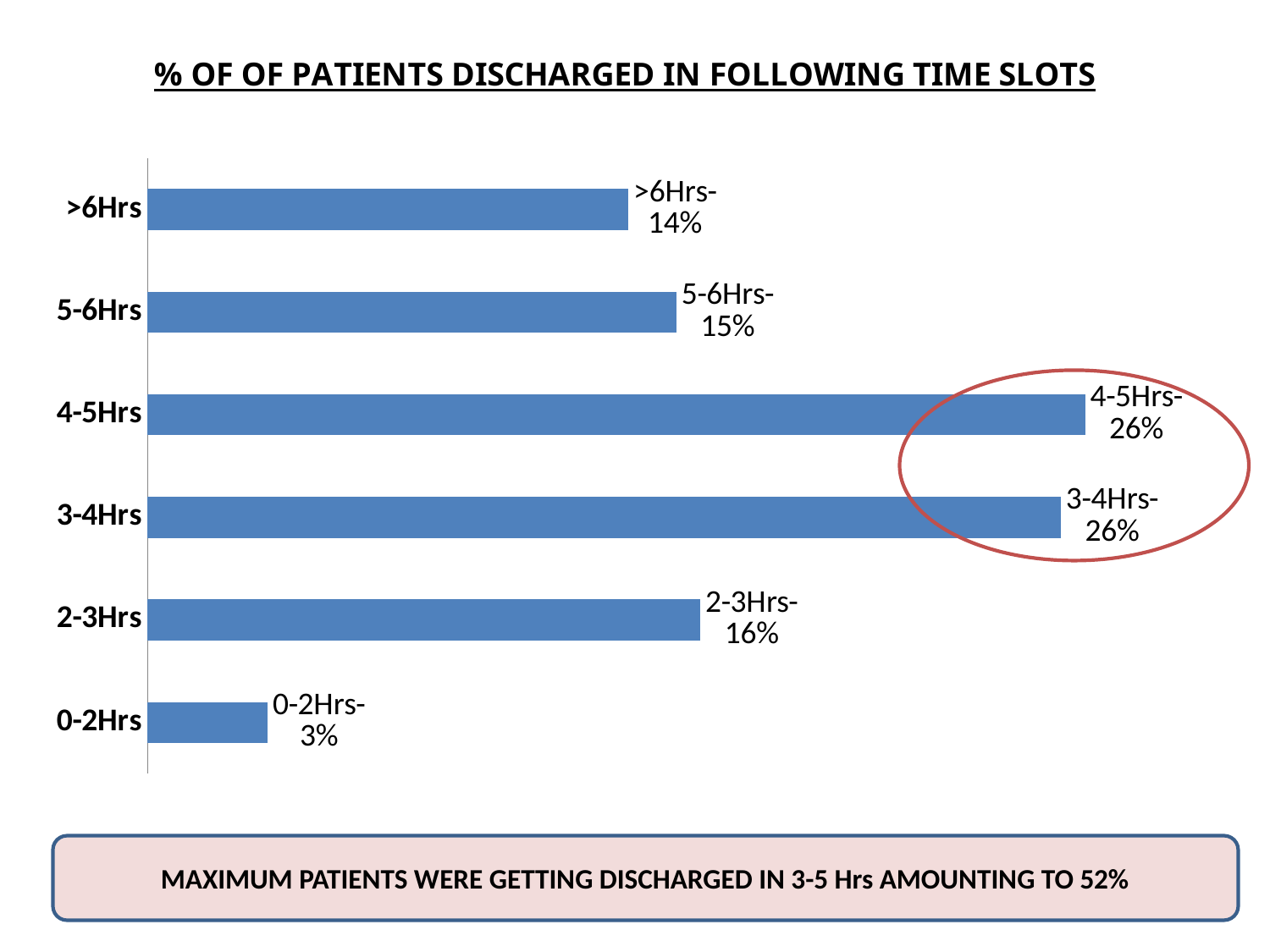
What is the difference in percentage points between the 2-3Hrs and 0-2Hrs time slots? 13 Which time slot has the lowest percentage of patients discharged? 0-2Hrs What percentage of patients were discharged in the >6Hrs time slot? 14% What percentage of patients were discharged in the 0-2Hrs time slot? 3% How many time slot categories are shown in the chart? 6 What is the title of the chart? % OF OF PATIENTS DISCHARGED IN FOLLOWING TIME SLOTS Which has a larger percentage of patients discharged, 2-3Hrs or >6Hrs? 2-3Hrs What type of chart is shown on the slide? Bar chart Which has a larger percentage of patients discharged, 5-6Hrs or 0-2Hrs? 5-6Hrs What percentage of patients were discharged in the 2-3Hrs time slot? 16% What percentage of patients were discharged in the 5-6Hrs time slot? 15% What is the difference in percentage points between the 4-5Hrs and 5-6Hrs time slots? 11